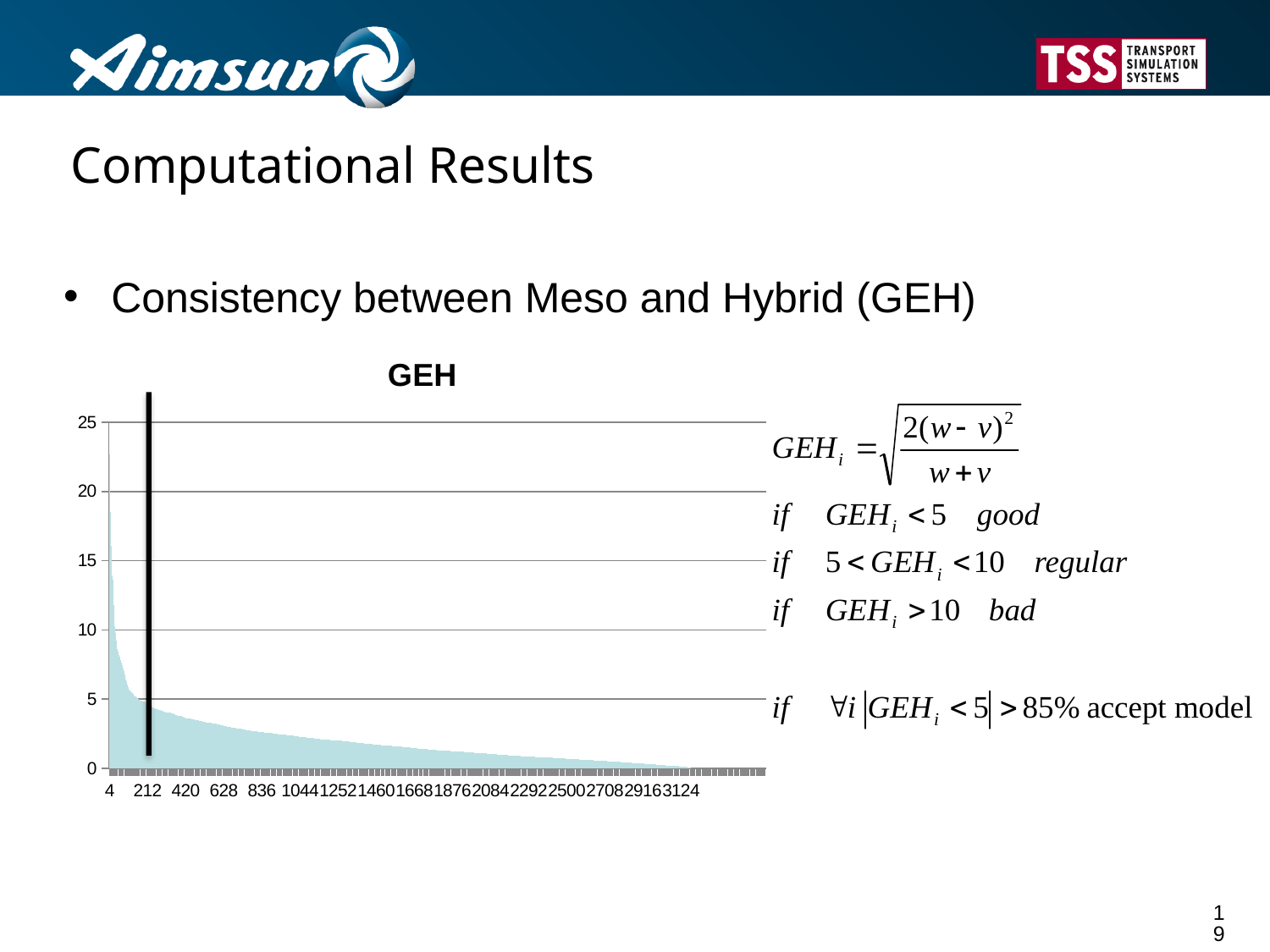
Is the value at x label 628 in the GEH chart greater or less than 10? less Do the values in the GEH chart rise or fall as you move from left to right along the x axis? fall Is the value at the left end of the GEH chart (x label 4) greater or less than 15? greater Is the value at x label 1044 in the GEH chart greater or less than 5? less What is the highest tick value shown on the y axis of the GEH chart? 25 Is the value at x label 4 larger or smaller than the value at x label 2500 in the GEH chart? larger What kind of chart is the GEH chart? area chart What is the title of the chart on the slide? GEH Which x-axis label in the GEH chart corresponds to the lowest value? 3124 Which x-axis label in the GEH chart corresponds to the highest value? 4 How many x-axis labels are printed on the GEH chart? 16